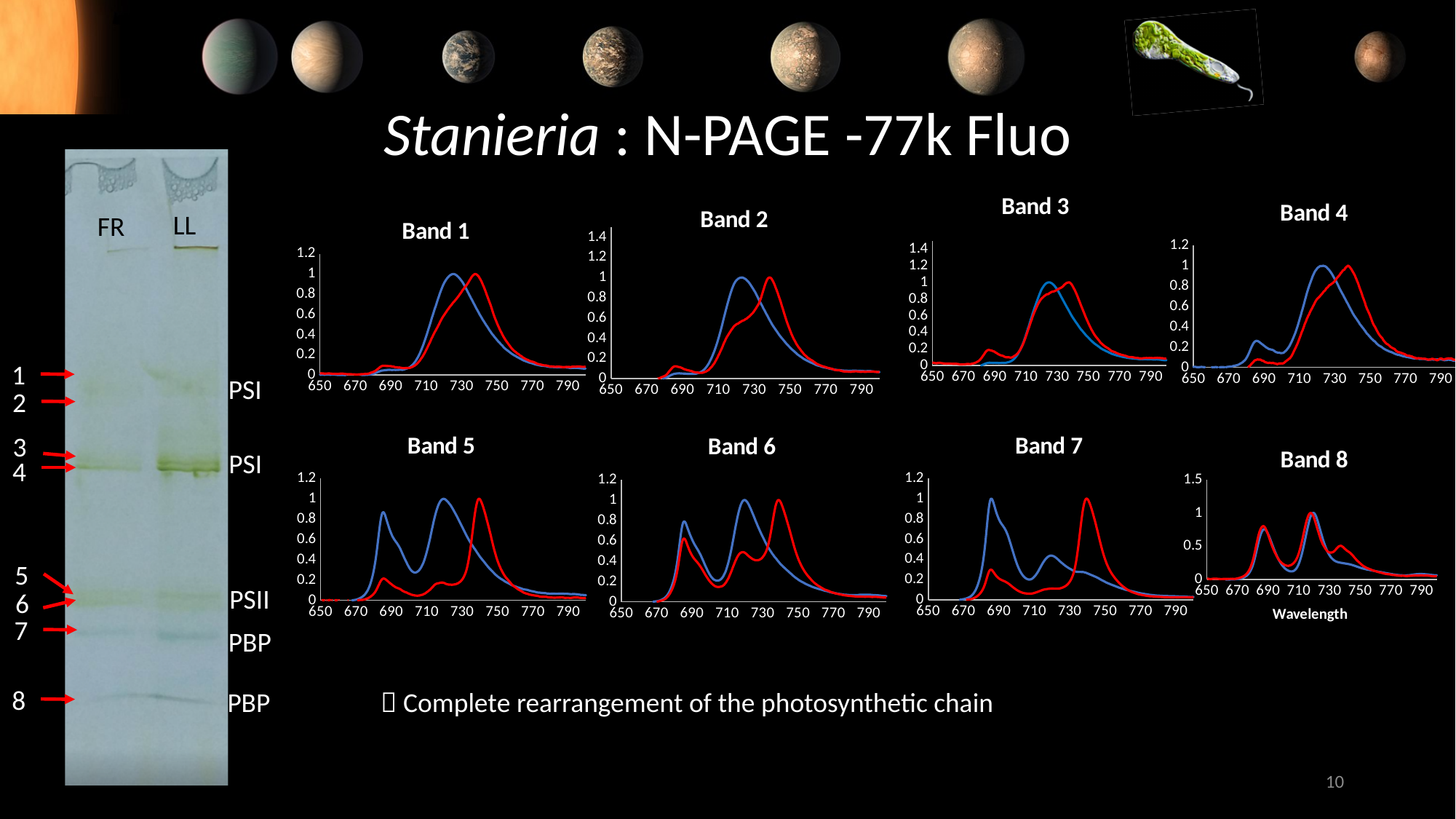
In the Band 7 chart, is the peak value of the blue line near 690 greater or less than 0.8? greater What is the x-axis label shown under the Band 8 chart? Wavelength In the Band 5 chart, at 690 which line has the larger value, blue or red? blue What is the highest tick value on the y-axis of the Band 8 chart? 1.5 In the Band 1 chart, which line reaches its peak at a longer wavelength, blue or red? red In the Band 7 chart, is the value of the blue line at 740 greater or less than 0.5? less How many lines are plotted in the Band 5 chart? 2 What kind of chart is the Band 1 chart? line chart In the Band 8 chart, is the peak of the red line near 690 greater or less than 0.5? greater How many band charts (Band 1 to Band 8) are shown on the slide? 8